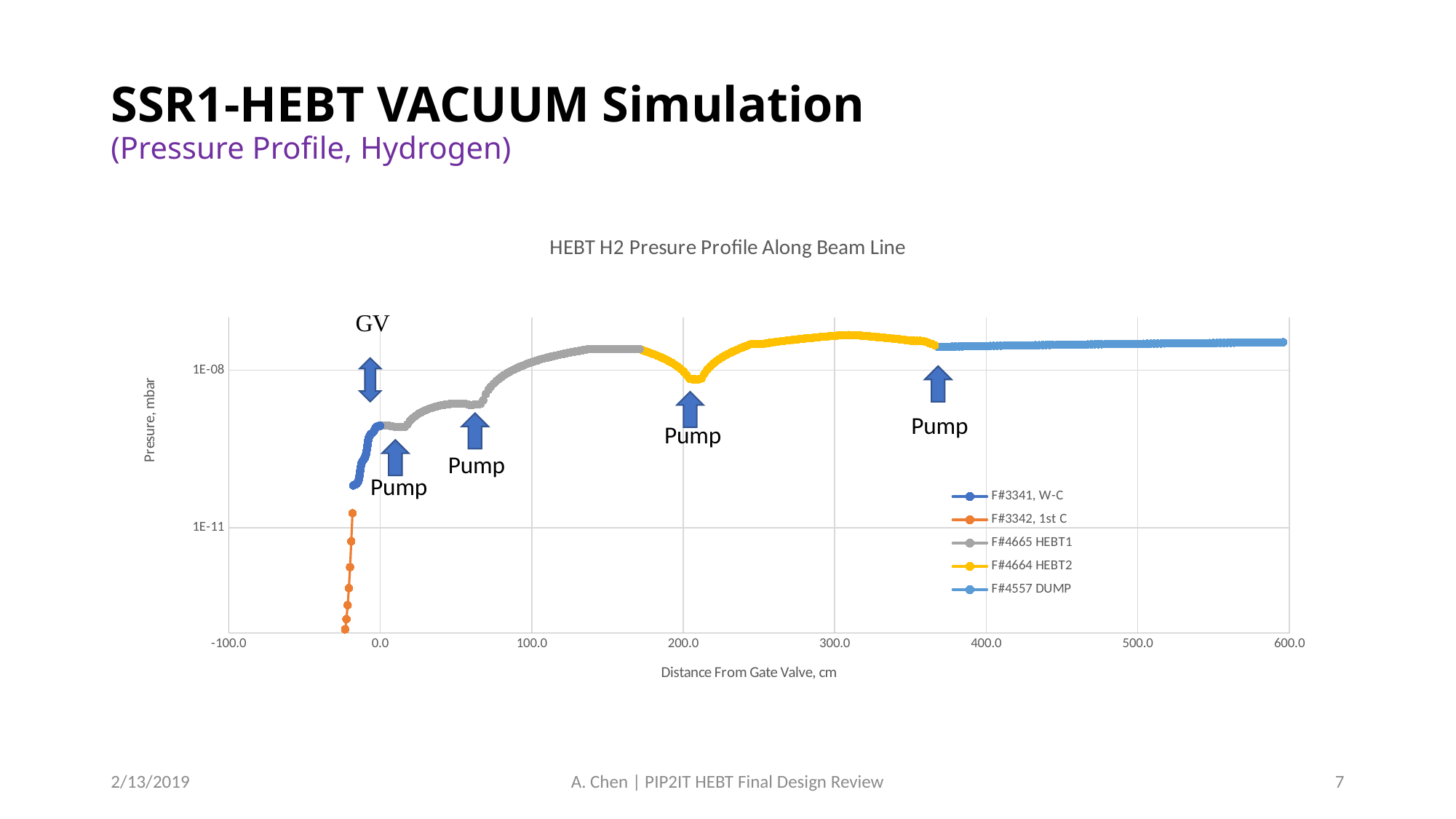
How many series does the legend list? 5 How many 'Pump' annotations are marked on the chart? 4 Is the pressure for the F#4557 DUMP series greater or less than 1E-08 mbar? greater Is the pressure for the F#4557 DUMP series greater or less than 1E-11 mbar? greater What kind of chart is shown on the slide? line chart Which series has the lowest pressure values on the chart? F#3342, 1st C Which series has higher pressure values, F#3342, 1st C or F#4665 HEBT1? F#4665 HEBT1 What is the label of the x axis? Distance From Gate Valve, cm Is the pressure for the F#3341, W-C series greater or less than 1E-08 mbar? less Overall, does the pressure rise or fall as the distance from the gate valve increases? rise What is the title of the chart? HEBT H2 Presure Profile Along Beam Line Which series has higher pressure values, F#3341, W-C or F#4557 DUMP? F#4557 DUMP